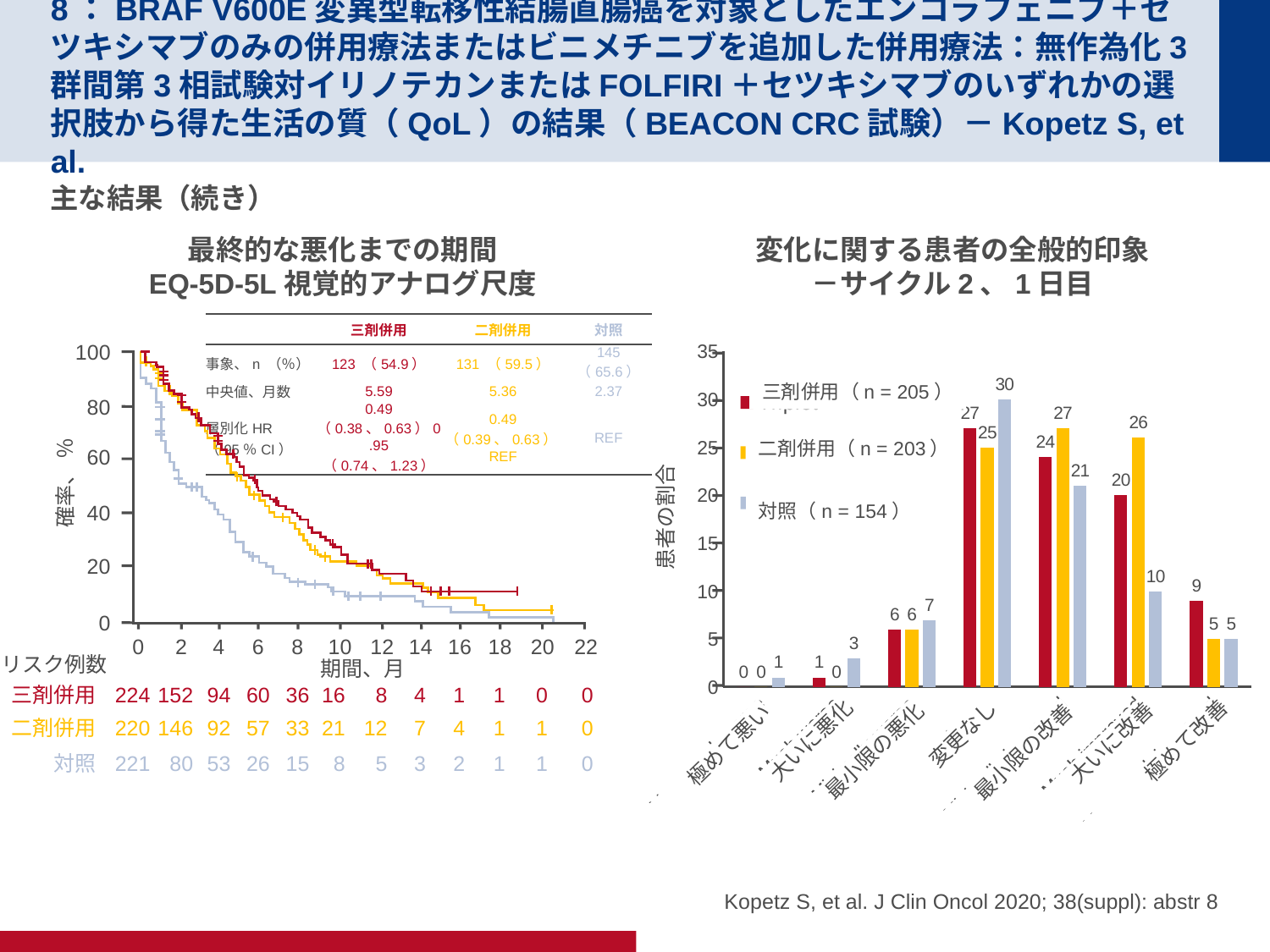
What kind of chart is the right-hand chart (変化に関する患者の全般的印象)? bar chart In the right-hand chart (変化に関する患者の全般的印象), what is the value for 二剤併用 in the 大いに改善 category? 26 In the right-hand chart (変化に関する患者の全般的印象), is the value for 三剤併用 in the 極めて改善 category larger or smaller than the value for 二剤併用 in that category? larger In the left-hand chart (最終的な悪化までの期間 EQ-5D-5L 視覚的アナログ尺度), what is the number at risk for 三剤併用 at month 0? 224 How many categories are shown on the x axis of the right-hand chart (変化に関する患者の全般的印象)? 7 How many series does the legend of the right-hand chart (変化に関する患者の全般的印象) list? 3 In the right-hand chart (変化に関する患者の全般的印象－サイクル2、1日目), what is the value for 三剤併用 in the 変更なし category? 27 In the right-hand chart (変化に関する患者の全般的印象), what is the difference between the 二剤併用 and 対照 values in the 大いに改善 category? 16 In the left-hand chart (最終的な悪化までの期間 EQ-5D-5L 視覚的アナログ尺度), what is the median time in months for the 対照 group according to the inset table? 2.37 In the right-hand chart (変化に関する患者の全般的印象), which series has the lowest value in the 大いに改善 category? 対照 In the right-hand chart (変化に関する患者の全般的印象), which series has the highest value in the 最小限の改善 category? 二剤併用 In the right-hand chart (変化に関する患者の全般的印象), what is the value for 対照 in the 変更なし category? 30